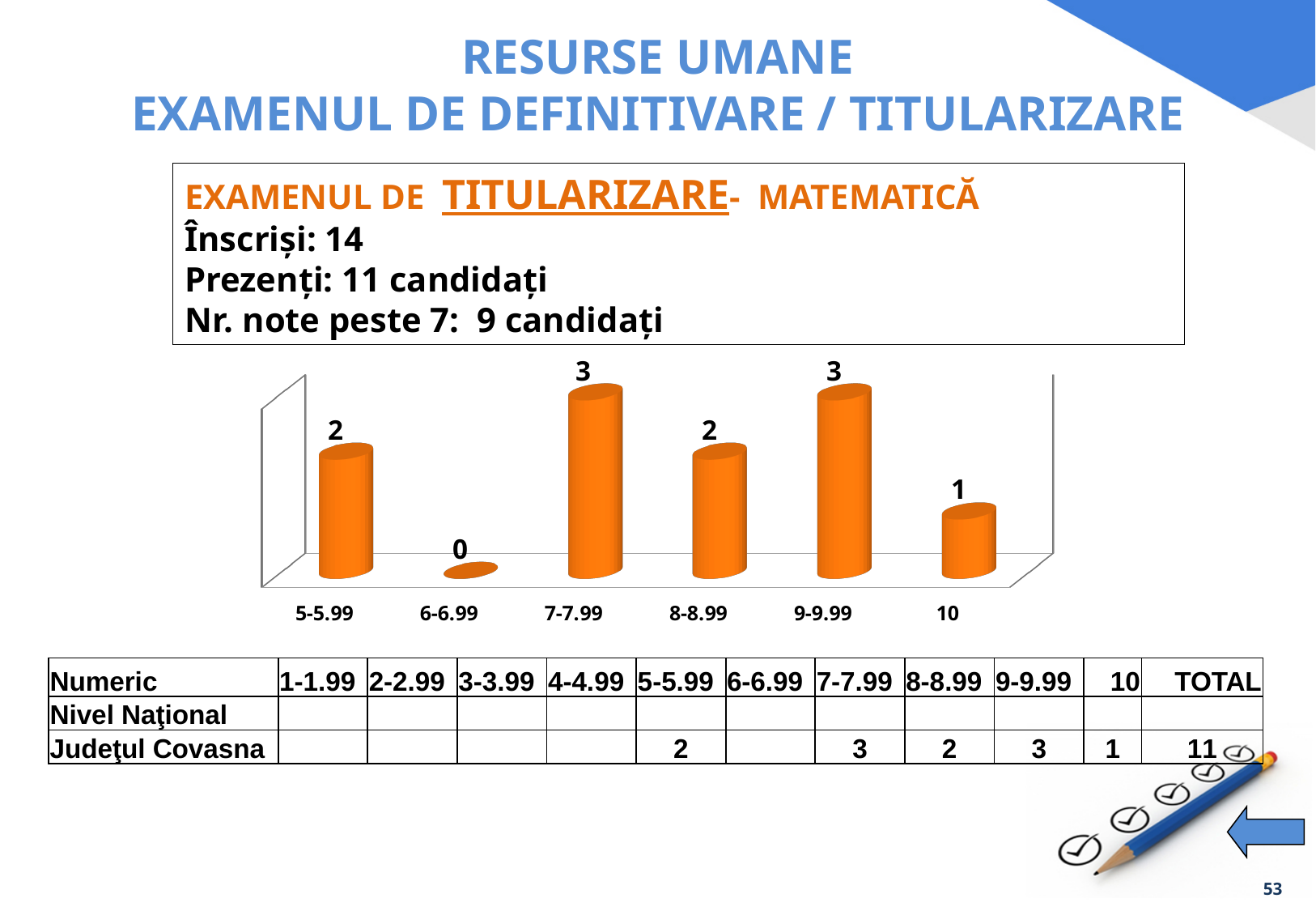
What colour are the bars in the chart? orange What is the value for the 7-7.99 category? 3 What is the value for the 5-5.99 category? 2 How many categories are shown on the x axis of the chart? 6 Which is larger, the value for 8-8.99 or the value for 10? 8-8.99 What is the value for the 10 category? 1 What is the difference between the values for 9-9.99 and 10? 2 What is the total of all the values shown in the chart? 11 Which category has the lowest value? 6-6.99 What is the value for the 6-6.99 category? 0 What kind of chart is shown on the slide? bar chart What is the difference between the values for 7-7.99 and 8-8.99? 1